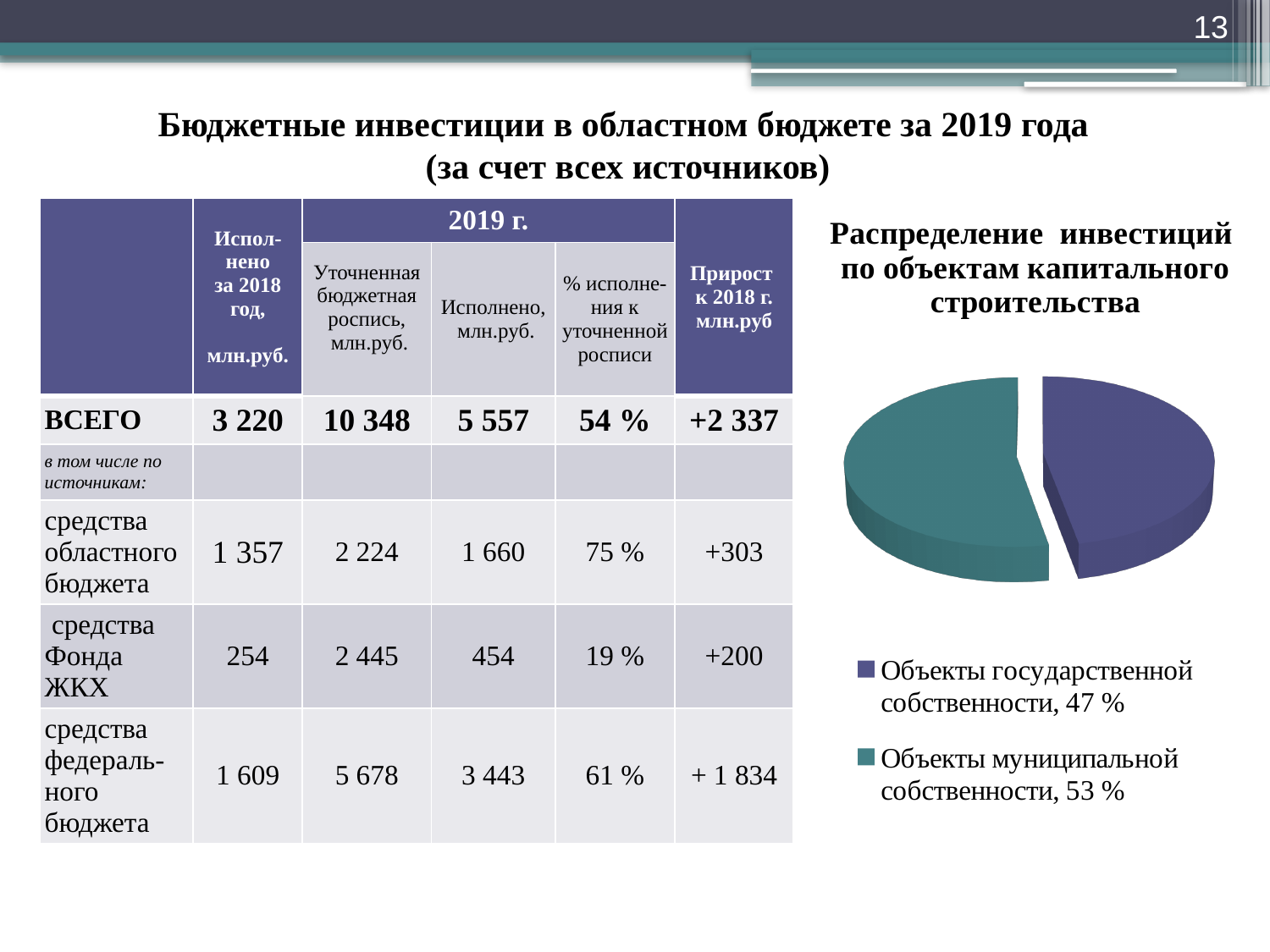
What kind of chart is shown on the slide? pie chart What share of the pie is 'Объекты муниципальной собственности'? 53 % What is the title of the pie chart? Распределение инвестиций по объектам капитального строительства How many entries does the pie chart legend list? 2 Which slice of the pie chart is the largest? Объекты муниципальной собственности Which colour represents 'Объекты муниципальной собственности' in the pie chart? teal (green) Which is larger in the pie chart: 'Объекты государственной собственности' or 'Объекты муниципальной собственности'? Объекты муниципальной собственности How many slices does the pie chart have? 2 What is the difference in percentage points between the 'Объекты муниципальной собственности' and 'Объекты государственной собственности' slices? 6 % What share of the pie is 'Объекты государственной собственности'? 47 % Which slice of the pie chart is the smallest? Объекты государственной собственности